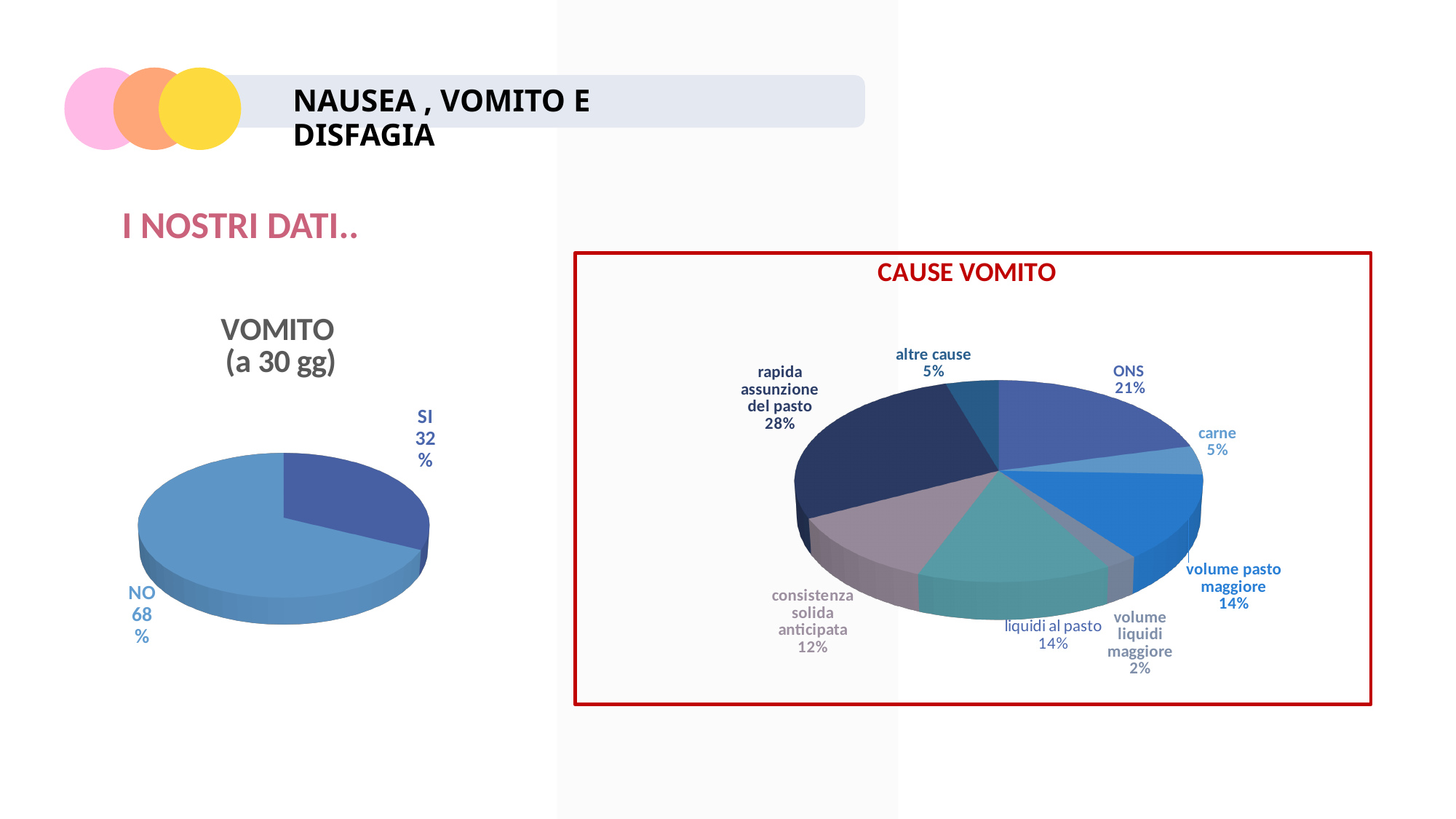
In the 'VOMITO (a 30 gg)' chart, which slice is larger, SI or NO? NO In the 'CAUSE VOMITO' chart, what percentage is attributed to ONS? 21% In the 'CAUSE VOMITO' chart, which cause has the largest share? rapida assunzione del pasto In the 'CAUSE VOMITO' chart, which is larger, the share for 'volume pasto maggiore' or the share for 'carne'? volume pasto maggiore In the 'VOMITO (a 30 gg)' chart, what percentage is shown for SI? 32% In the 'CAUSE VOMITO' chart, what is the difference between the shares of ONS and 'consistenza solida anticipata'? 9% In the 'CAUSE VOMITO' chart, which cause has the smallest share? volume liquidi maggiore In the 'CAUSE VOMITO' chart, what percentage is attributed to 'rapida assunzione del pasto'? 28% How many causes are shown in the 'CAUSE VOMITO' chart? 8 In the 'VOMITO (a 30 gg)' chart, what percentage is shown for NO? 68% In the 'VOMITO (a 30 gg)' chart, what is the difference between the NO and SI percentages? 36% What kind of chart is the 'CAUSE VOMITO' chart? Pie chart